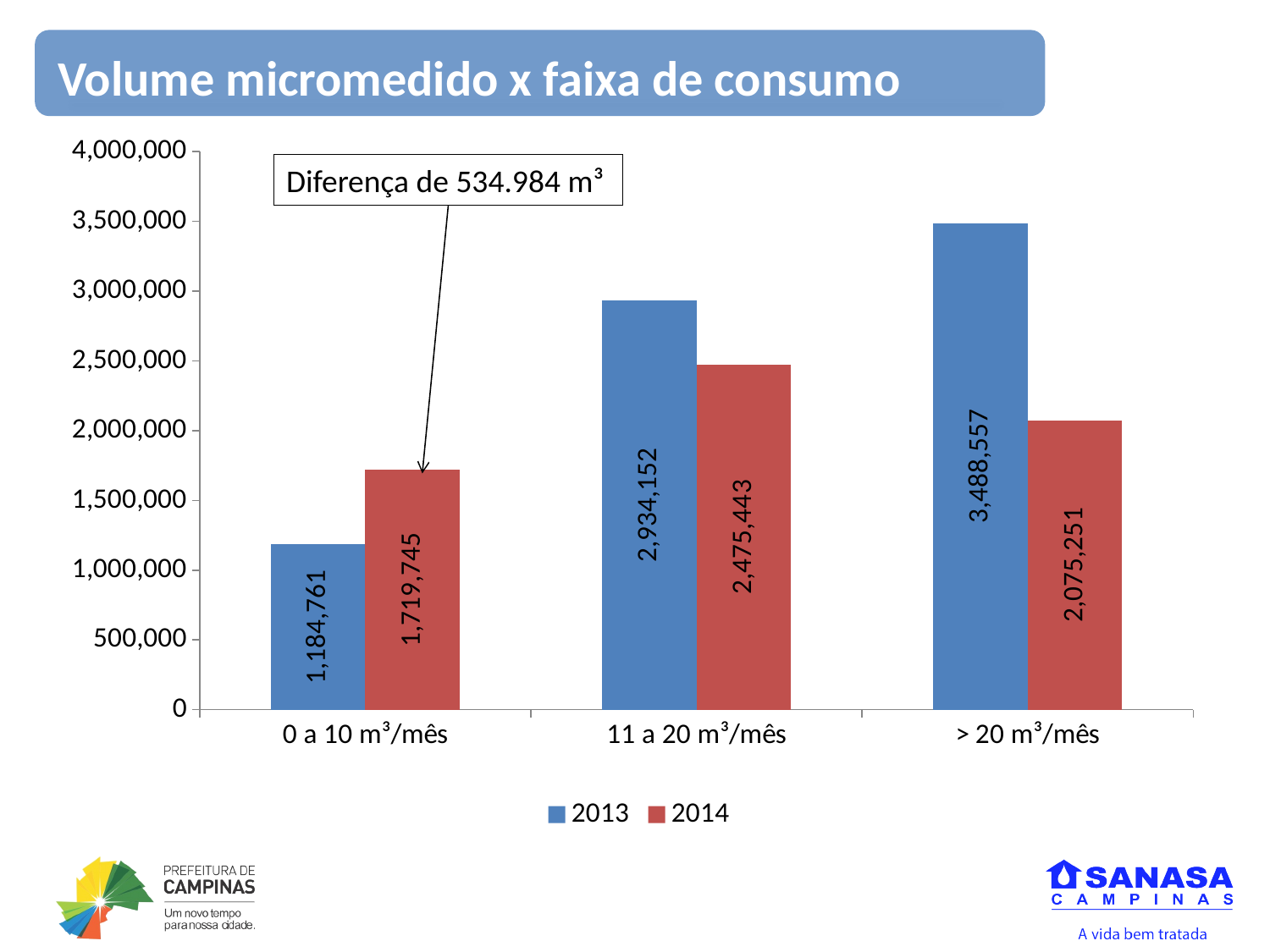
What is the 2014 value for the "11 a 20 m³/mês" category? 2,475,443 What is the difference between the 2014 and 2013 values for "0 a 10 m³/mês"? 534,984 What is the 2013 value for the "0 a 10 m³/mês" category? 1,184,761 How many series does the legend list? 2 What type of chart is shown on the slide? Bar chart What is the 2014 value for the "> 20 m³/mês" category? 2,075,251 For "11 a 20 m³/mês", which year has the larger value, 2013 or 2014? 2013 How many categories are shown on the x axis? 3 Which category has the lowest 2014 value? 0 a 10 m³/mês Which category has the highest 2013 value? > 20 m³/mês Is the 2013 value for "> 20 m³/mês" greater or less than 3,000,000? greater What is the difference between the 2013 and 2014 values for "> 20 m³/mês"? 1,413,306